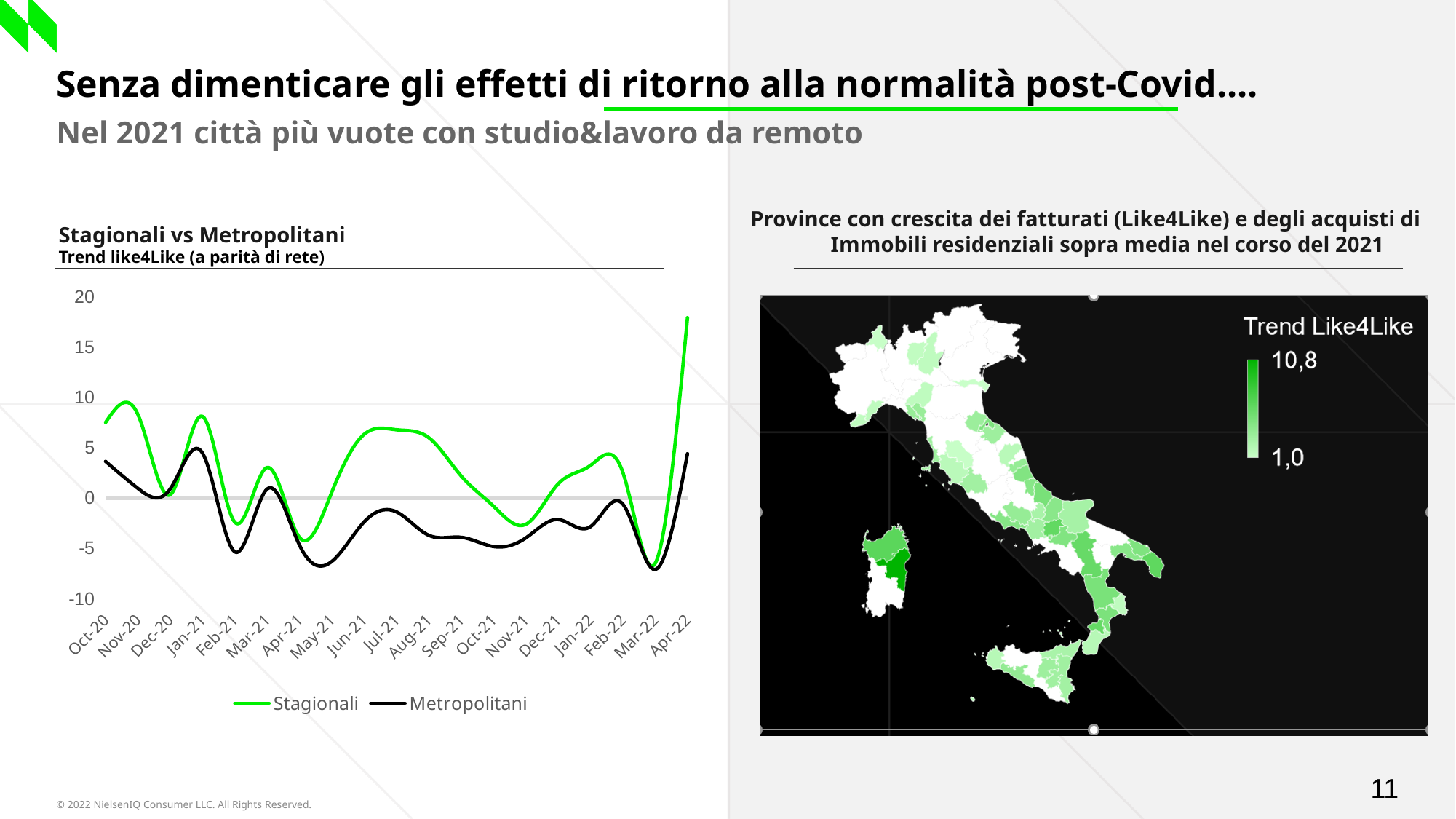
In the 'Stagionali vs Metropolitani' chart, is the Stagionali value for Apr-22 greater or less than 15? greater In the 'Stagionali vs Metropolitani' chart, in which month does the Stagionali series reach its highest value? Apr-22 In the 'Stagionali vs Metropolitani' chart, which series has the larger value in Apr-22, Stagionali or Metropolitani? Stagionali On the map chart on the right, what are the maximum and minimum values shown on the 'Trend Like4Like' colour scale? 10,8 and 1,0 In the 'Stagionali vs Metropolitani' chart, which colour is used for the Stagionali series? green How many months are shown on the x axis of the 'Stagionali vs Metropolitani' chart? 19 What kind of chart is the 'Stagionali vs Metropolitani' chart? line chart In the 'Stagionali vs Metropolitani' chart, is the Metropolitani value for Jul-21 greater or less than 0? less In the 'Stagionali vs Metropolitani' chart, in which month does the Stagionali series reach its lowest value? Mar-22 In the 'Stagionali vs Metropolitani' chart, is the Stagionali value for Jul-21 greater or less than 5? greater How many series does the legend of the 'Stagionali vs Metropolitani' chart list? 2